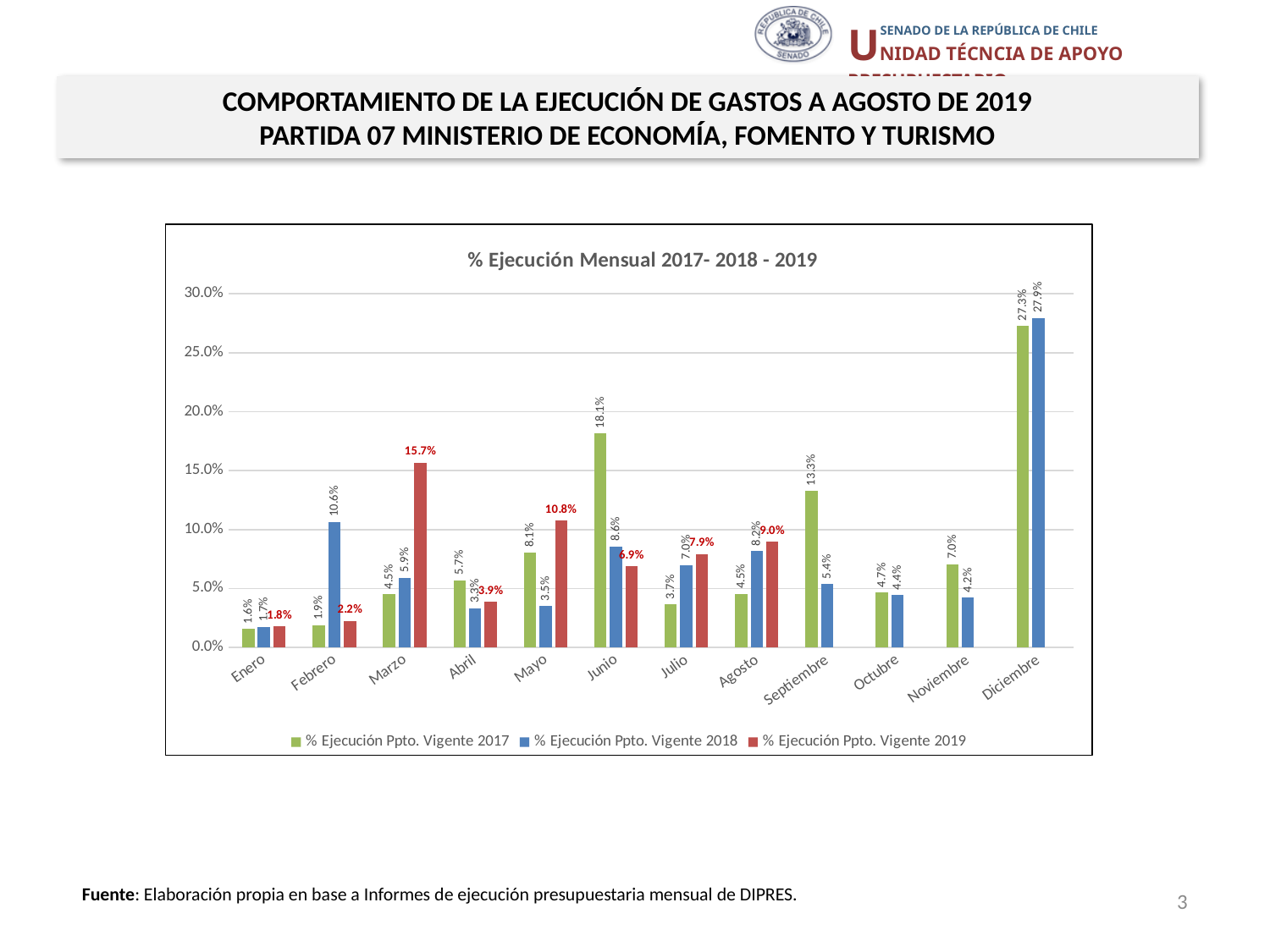
What is the difference between the 2019 and 2017 values for Mayo? 2.7% What is the % Ejecución Ppto. Vigente 2017 value for Junio? 18.1% What kind of chart is shown on the slide? Bar chart How many series does the legend list? 3 What is the % Ejecución Ppto. Vigente 2018 value for Febrero? 10.6% How many months are shown on the x axis? 12 What is the % Ejecución Ppto. Vigente 2019 value for Marzo? 15.7% Which month has the lowest % Ejecución Ppto. Vigente 2017 value? Enero Is the % Ejecución Ppto. Vigente 2017 value for Septiembre greater or less than 10.0%? greater What is the title of the chart? % Ejecución Mensual 2017- 2018 - 2019 Which is larger for Junio: the 2017 value or the 2018 value? 2017 value Which month has the highest % Ejecución Ppto. Vigente 2018 value? Diciembre